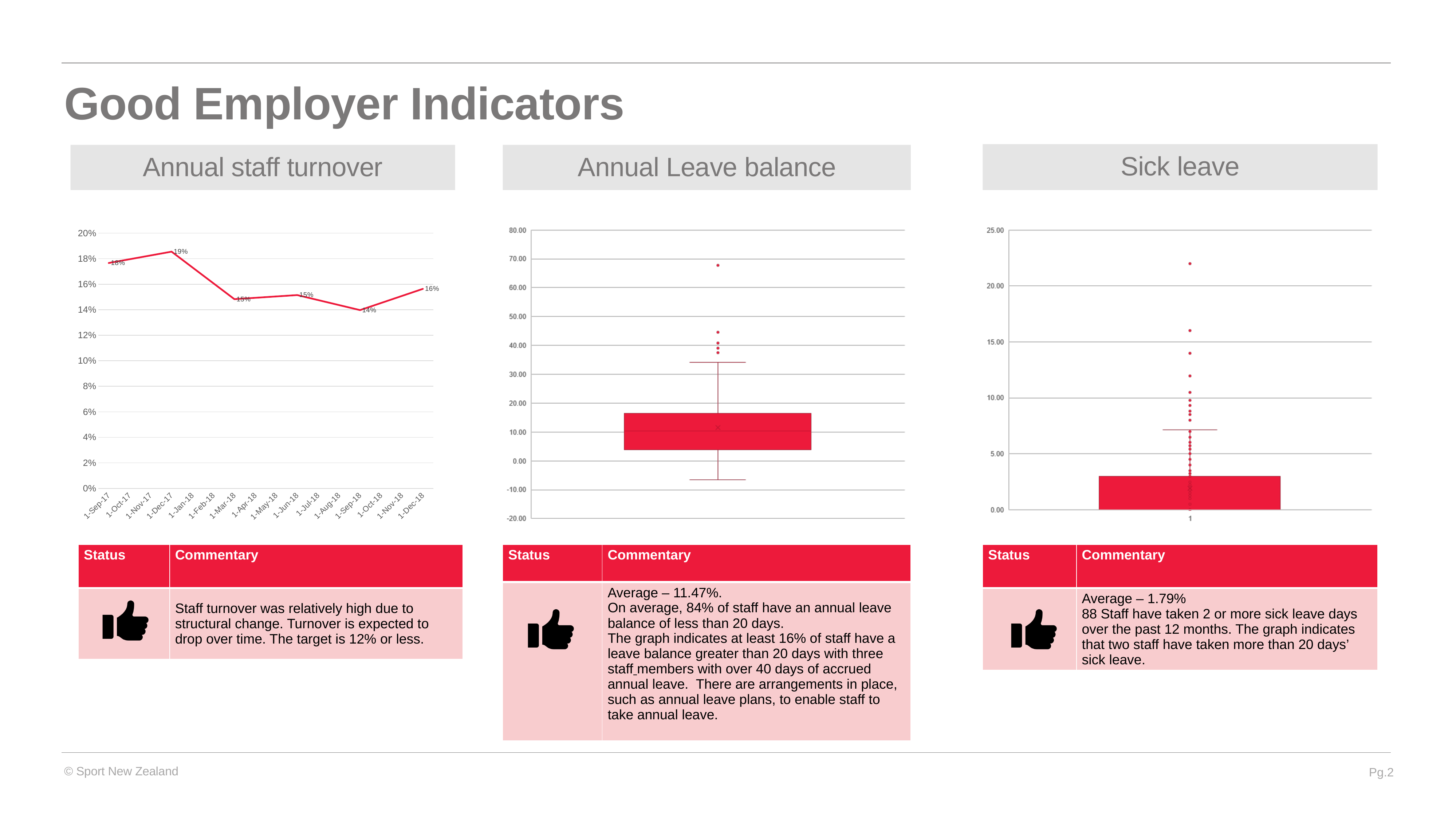
On the Annual Leave balance chart, is the highest plotted point greater or less than 60.00? greater How many charts are shown on the slide? 3 On the Annual staff turnover chart, what is the turnover value at 1-Sep-18? 14% On the Annual staff turnover chart, what is the turnover value at 1-Dec-17? 19% On the Sick leave chart, is the highest plotted point greater or less than 20.00? greater On the Annual staff turnover chart, which is larger: the turnover at 1-Sep-17 or at 1-Dec-18? 1-Sep-17 What kind of chart is the Annual staff turnover chart? Line chart On the Annual staff turnover chart, what is the difference between the turnover at 1-Dec-17 and at 1-Sep-18? 5 percentage points On the Annual staff turnover chart, at which date is turnover lowest? 1-Sep-18 On the Annual staff turnover chart, how many data points are plotted on the line? 6 On the Annual staff turnover chart, does the line rise or fall between 1-Dec-17 and 1-Sep-18? Fall On the Annual staff turnover chart, at which date is turnover highest? 1-Dec-17